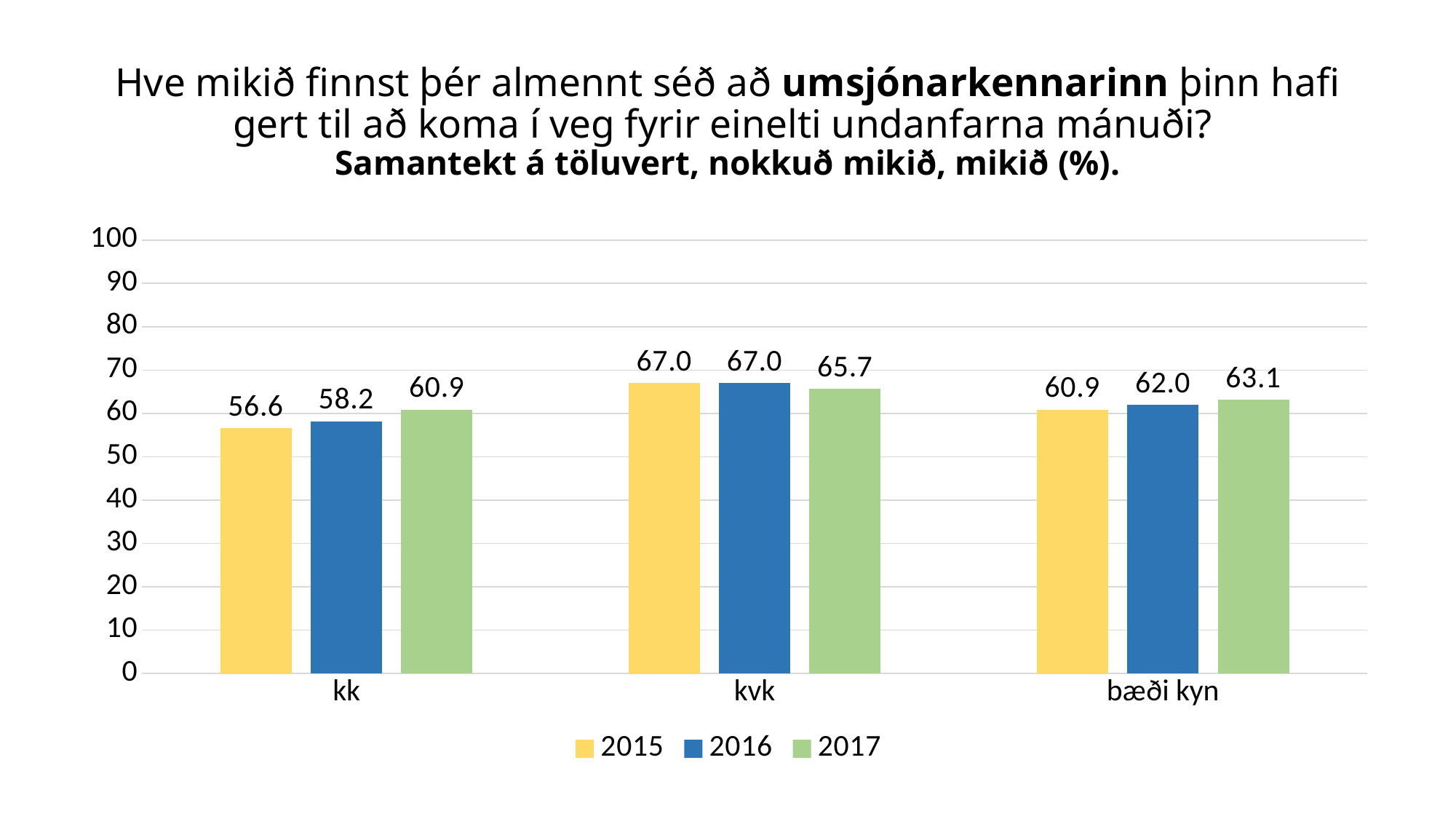
What is the difference between the kvk and kk values in 2016? 8.8 What is the value for kk in 2015? 56.6 How many series does the legend list? 3 What is the difference between the 2017 and 2015 values for kk? 4.3 What kind of chart is shown on the slide? bar chart Which is larger: the 2017 value for bæði kyn or the 2017 value for kk? bæði kyn Which category has the highest value in 2015? kvk Do the values for kk rise or fall from 2015 to 2017? rise How many categories are shown on the x axis? 3 What is the value for kvk in 2017? 65.7 Which category has the lowest value in 2017? kk What is the value for bæði kyn in 2016? 62.0